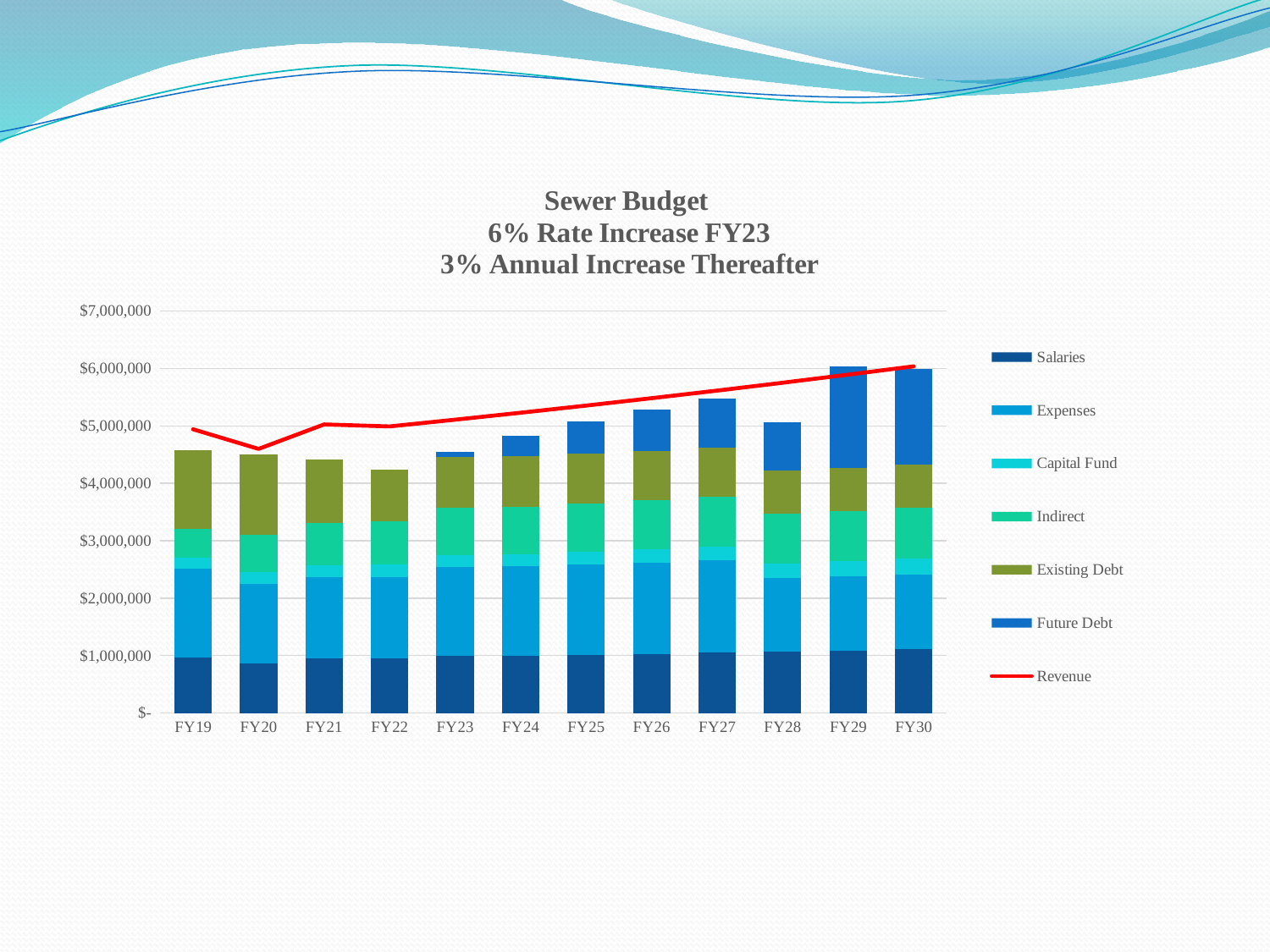
Which series is drawn as a line rather than as bars? Revenue Which fiscal year has the lowest total stacked bar? FY22 How many entries does the chart's legend list? 7 Is the Revenue value for FY27 greater or less than $5,000,000? greater Is the total stacked bar for FY27 greater or less than $5,000,000? greater Is the total stacked bar for FY22 greater or less than $5,000,000? less Does the Revenue line generally rise or fall from FY20 to FY30? rise What is the title of the chart? Sewer Budget 6% Rate Increase FY23 3% Annual Increase Thereafter How many fiscal years are shown on the x axis of the chart? 12 What kind of chart is shown on the slide? Stacked bar chart with a line Which has the larger total stacked bar, FY22 or FY27? FY27